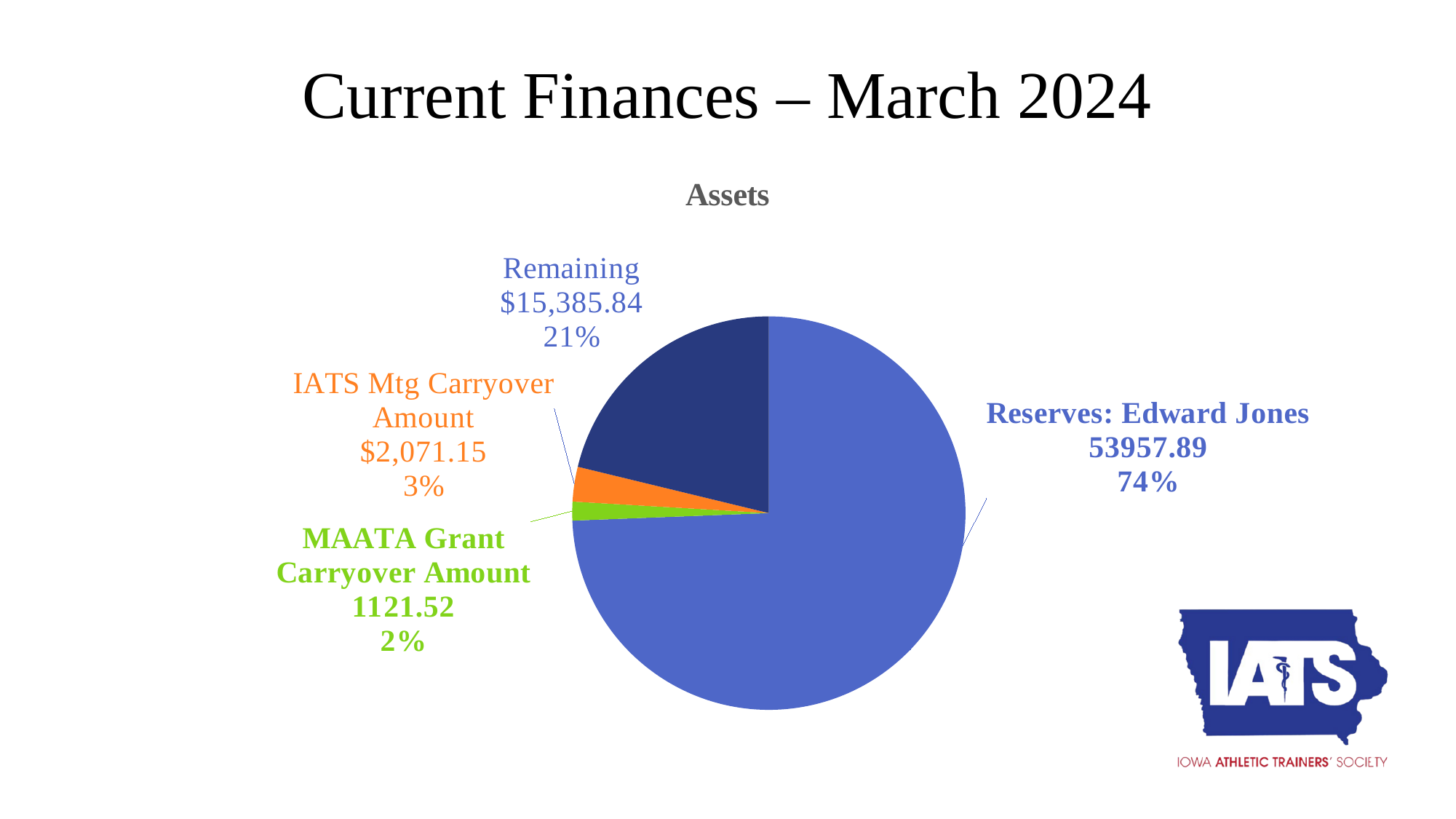
What is the value shown for Remaining? $15,385.84 What kind of chart is shown on the slide? pie chart What share of the pie does Remaining represent? 21% What is the value shown for MAATA Grant Carryover Amount? 1121.52 What is the value shown for Reserves: Edward Jones? 53957.89 Which category has the largest slice of the pie? Reserves: Edward Jones What is the title of the chart? Assets Which is larger, the Remaining slice or the IATS Mtg Carryover Amount slice? Remaining What share of the pie does Reserves: Edward Jones represent? 74% How many slices does the pie chart have? 4 What is the value shown for IATS Mtg Carryover Amount? $2,071.15 Which category has the smallest slice of the pie? MAATA Grant Carryover Amount